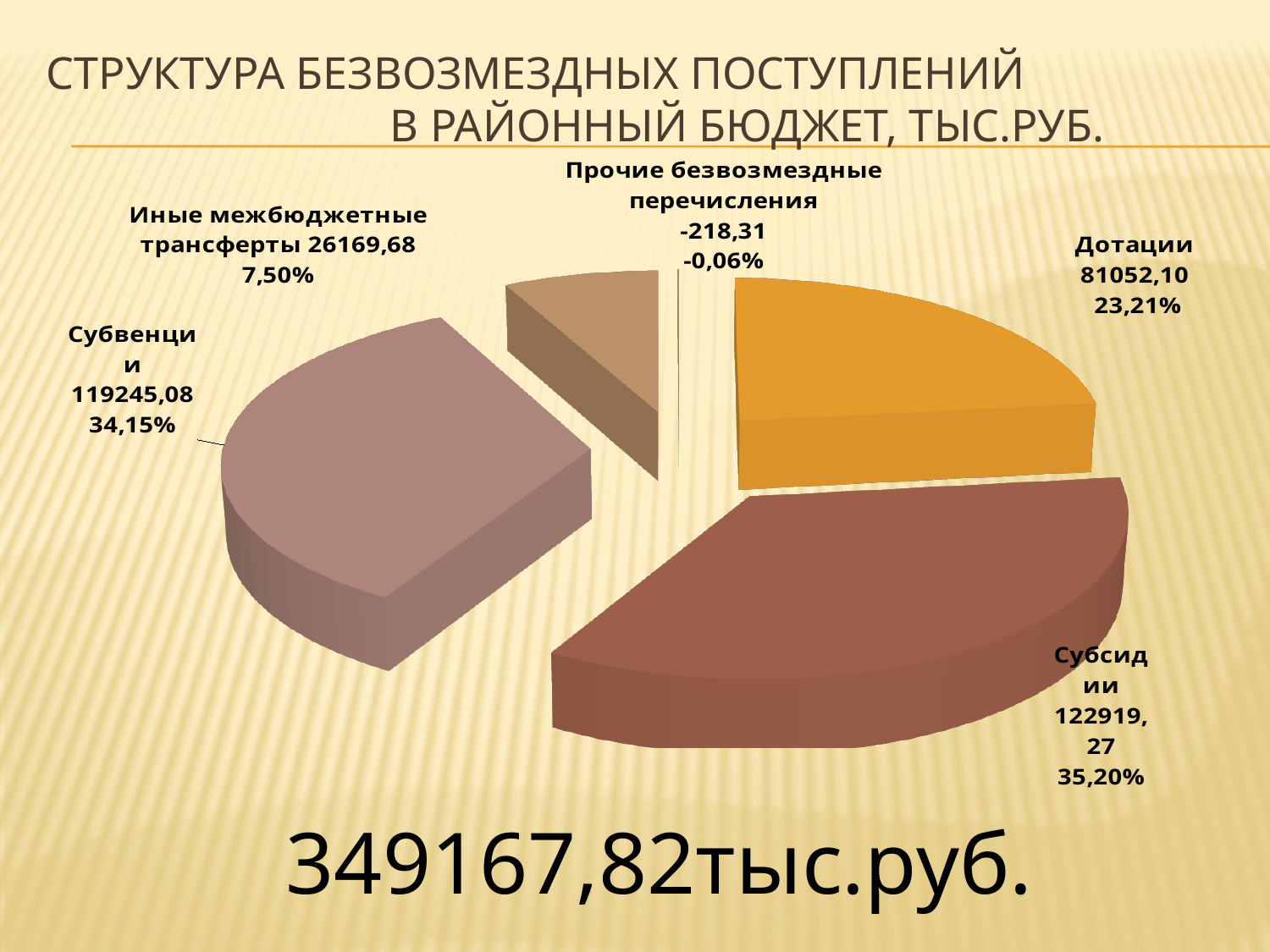
What share of the pie does Дотации represent? 23,21% Which category has the largest value? Субсидии What is the value for Дотации? 81052,10 What kind of chart is shown on the slide? pie chart What share of the pie does Субвенции represent? 34,15% What is the difference between the values for Субсидии and Дотации? 41867,17 What is the value for Иные межбюджетные трансферты? 26169,68 What is the value for Субсидии? 122919,27 How many categories (slices) does the pie chart show? 5 What is the value for Прочие безвозмездные перечисления? -218,31 What is the value for Субвенции? 119245,08 Which category has the smallest value? Прочие безвозмездные перечисления